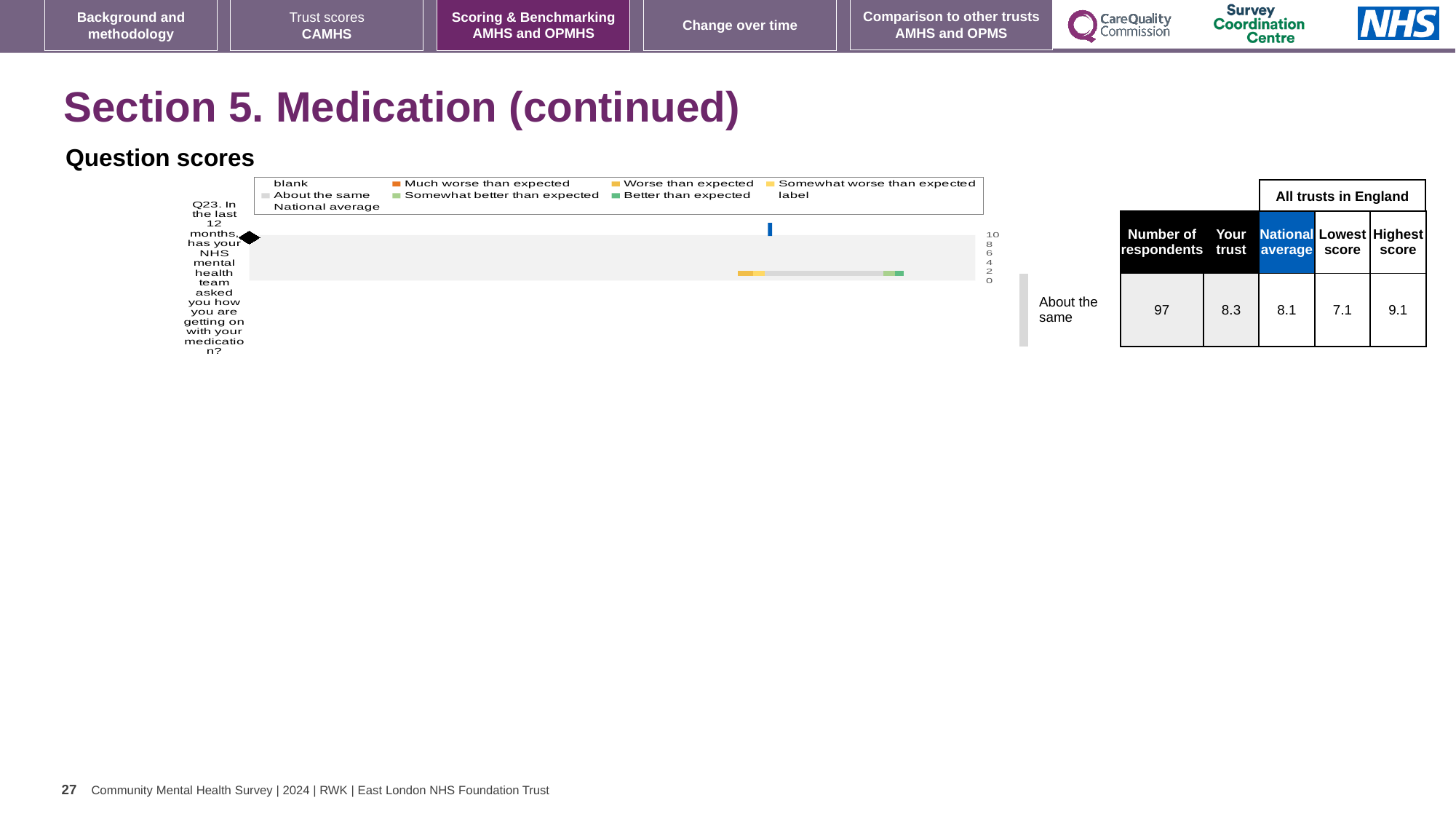
Which is higher for Q23: the 'Your trust' score or the national average? Your trust What is the 'Your trust' score for Q23 (asked how you are getting on with your medication)? 8.3 What is the highest value shown on the chart's score axis? 10 What kind of chart is used to show the Q23 question score? bar chart What is the difference between the highest score and the lowest score for Q23? 2.0 What is the highest score among all trusts in England for Q23? 9.1 What is the national average score for Q23? 8.1 How many respondents answered Q23? 97 What is the difference between the 'Your trust' score and the national average for Q23? 0.2 What is the lowest score among all trusts in England for Q23? 7.1 How is the trust's Q23 result categorised relative to expectation? About the same How many questions are plotted on the chart? 1